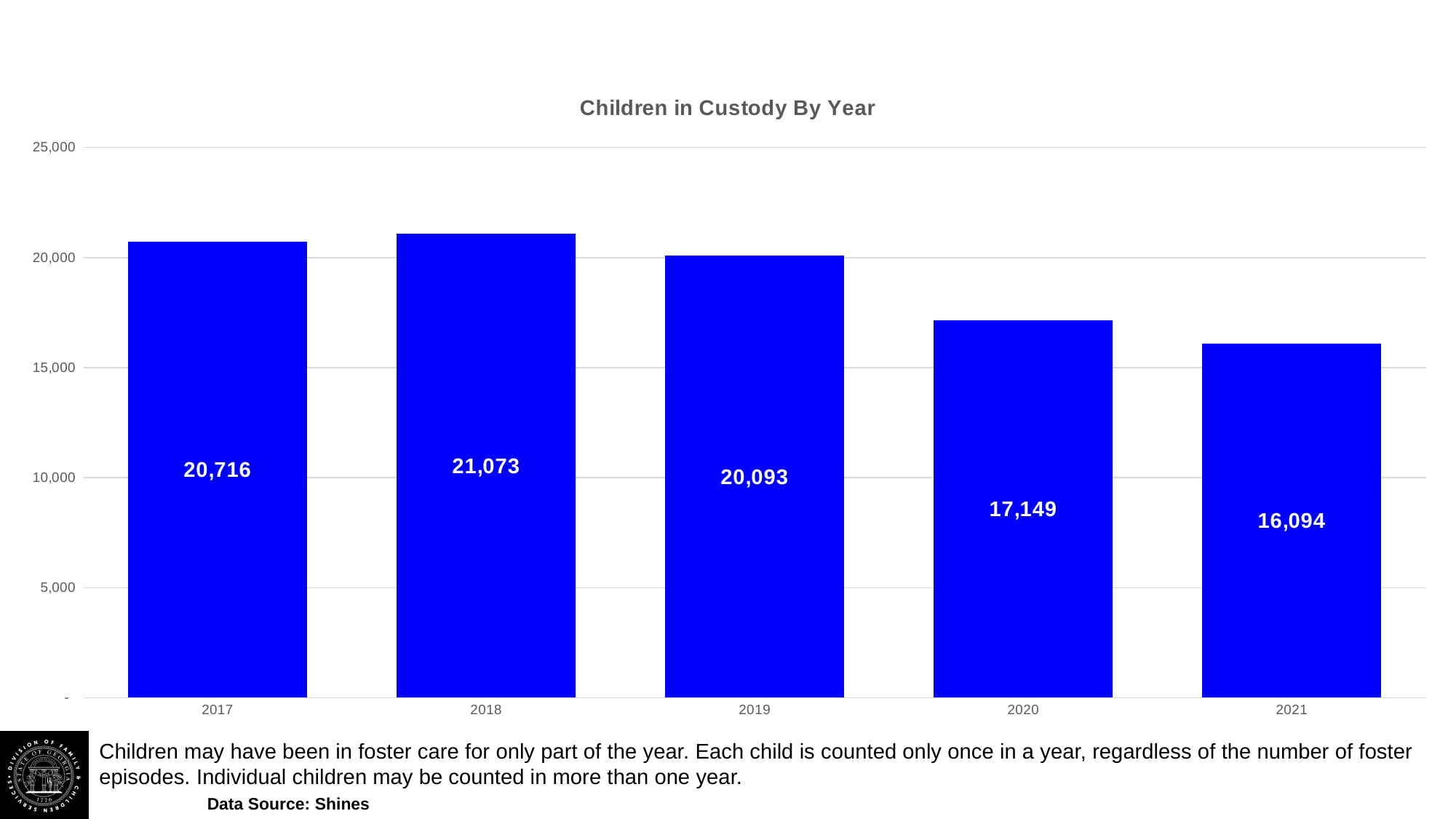
How many years are shown on the chart? 5 What kind of chart is shown on the slide? Bar chart What is the title of the chart? Children in Custody By Year Which year has more children in custody, 2017 or 2020? 2017 What is the difference between the number of children in custody in 2018 and in 2021? 4,979 Is the value for 2020 greater or less than 20,000? less Which year has the lowest number of children in custody? 2021 What is the difference between the number of children in custody in 2019 and in 2020? 2,944 What is the number of children in custody in 2019? 20,093 What is the number of children in custody in 2021? 16,094 What is the number of children in custody in 2017? 20,716 Which year has the highest number of children in custody? 2018